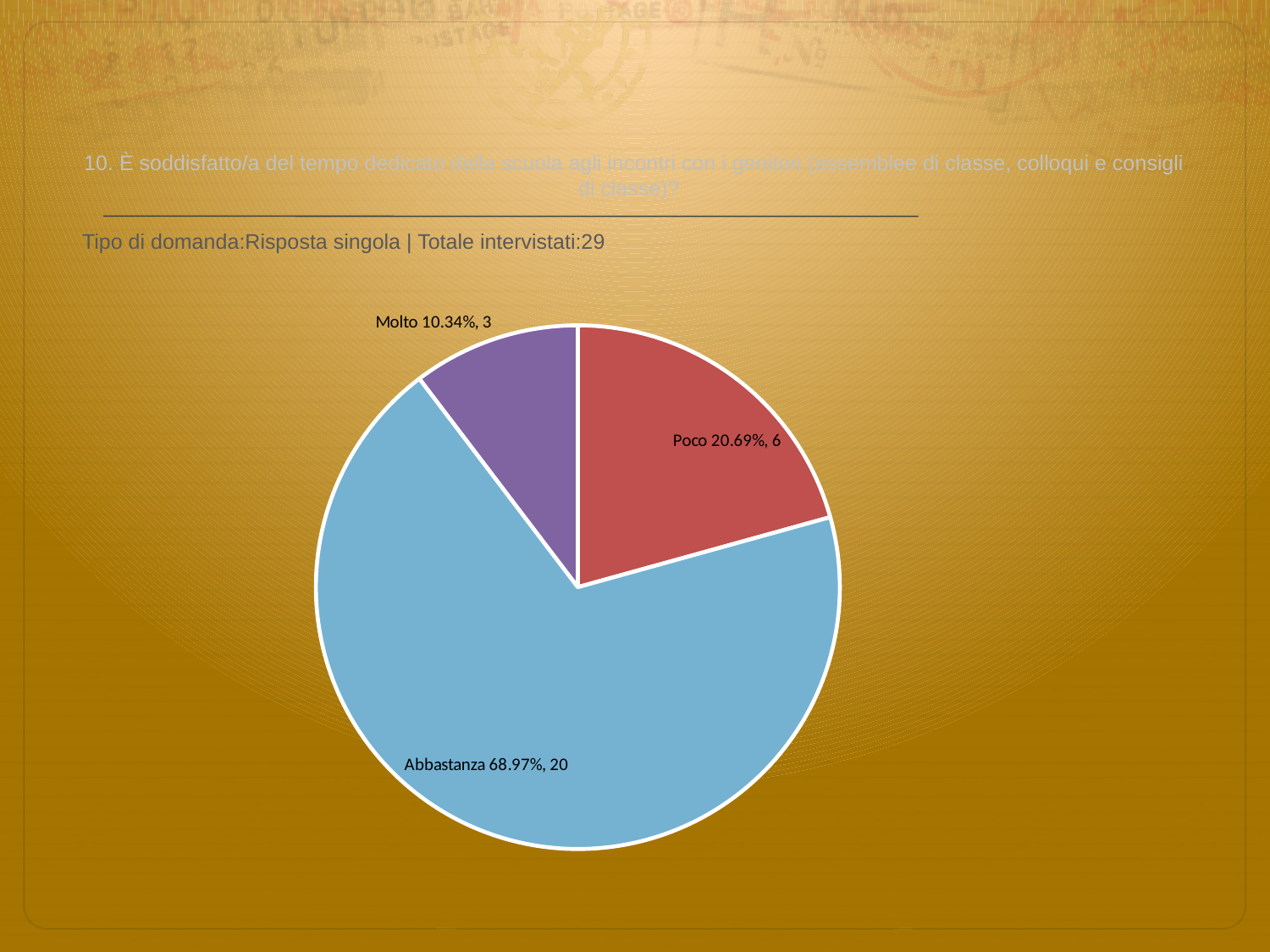
What kind of chart is shown on the slide? pie chart How many respondents answered Molto? 3 How many respondents answered Poco? 6 How many respondents answered Abbastanza? 20 What percentage share does the Abbastanza slice have? 68.97% What percentage share does the Molto slice have? 10.34% What percentage share does the Poco slice have? 20.69% How many slices does the pie chart have? 3 Which category has the largest slice? Abbastanza Which has more respondents, Poco or Molto? Poco Which category has the smallest slice? Molto What is the difference in respondent count between Poco and Molto? 3